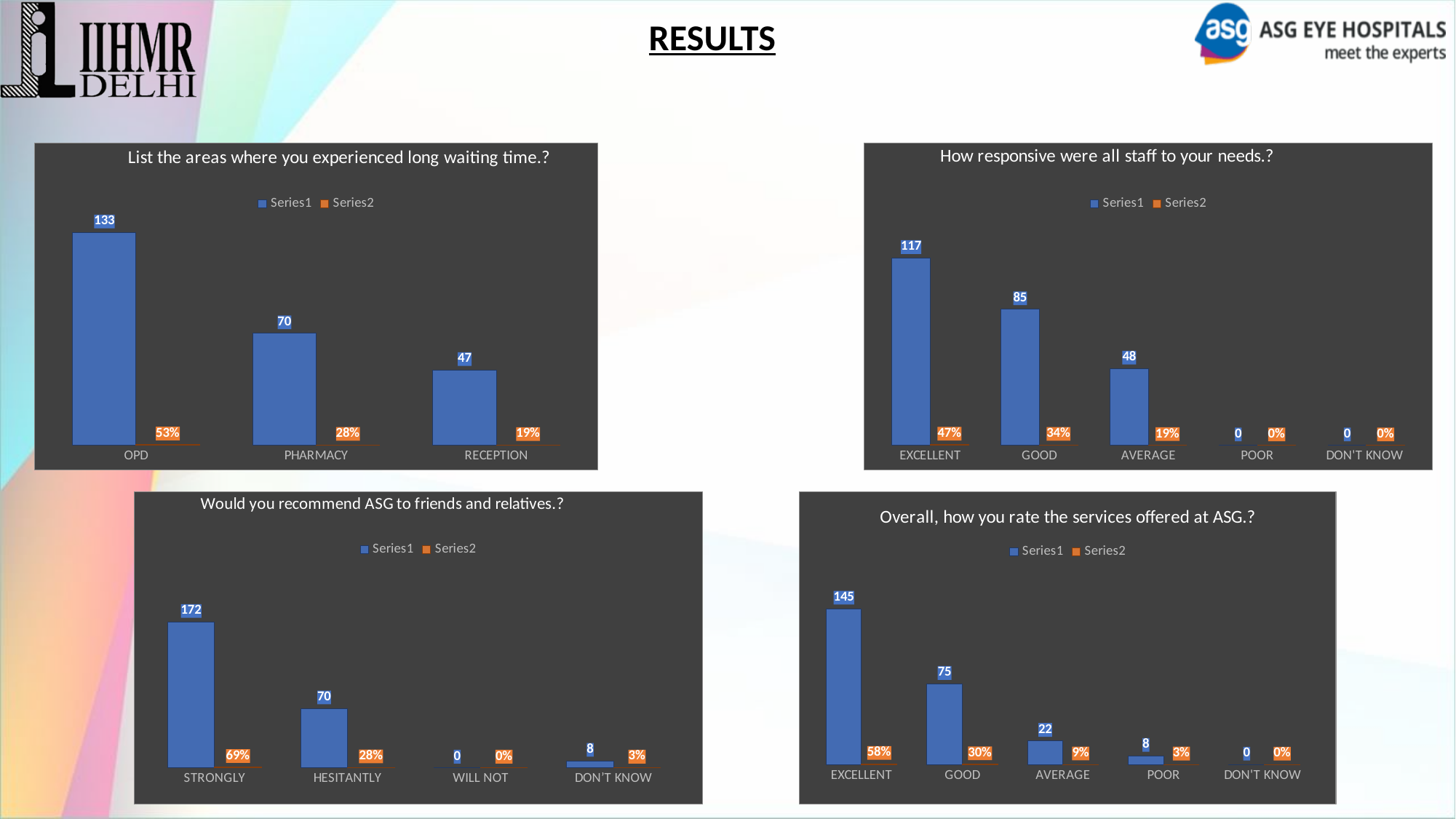
In the chart titled "Would you recommend ASG to friends and relatives.?", how many series does the legend list? 2 In the chart titled "Would you recommend ASG to friends and relatives.?", what is the Series1 value for DON'T KNOW? 8 What kind of chart is the chart titled "Overall, how you rate the services offered at ASG.?"? Bar chart In the chart titled "List the areas where you experienced long waiting time.?", how many categories are shown on the x axis? 3 In the chart titled "List the areas where you experienced long waiting time.?", what is the Series2 value for PHARMACY? 28% In the chart titled "List the areas where you experienced long waiting time.?", what is the Series1 value for OPD? 133 In the chart titled "Would you recommend ASG to friends and relatives.?", what is the Series2 value for STRONGLY? 69% In the chart titled "Overall, how you rate the services offered at ASG.?", what is the Series1 value for GOOD? 75 In the chart titled "How responsive were all staff to your needs.?", what is the difference between the Series1 values for EXCELLENT and GOOD? 32 In the chart titled "How responsive were all staff to your needs.?", what is the Series1 value for AVERAGE? 48 In the chart titled "Overall, how you rate the services offered at ASG.?", which is larger, the Series1 value for AVERAGE or for POOR? AVERAGE In the chart titled "How responsive were all staff to your needs.?", which category has the highest Series1 value? EXCELLENT